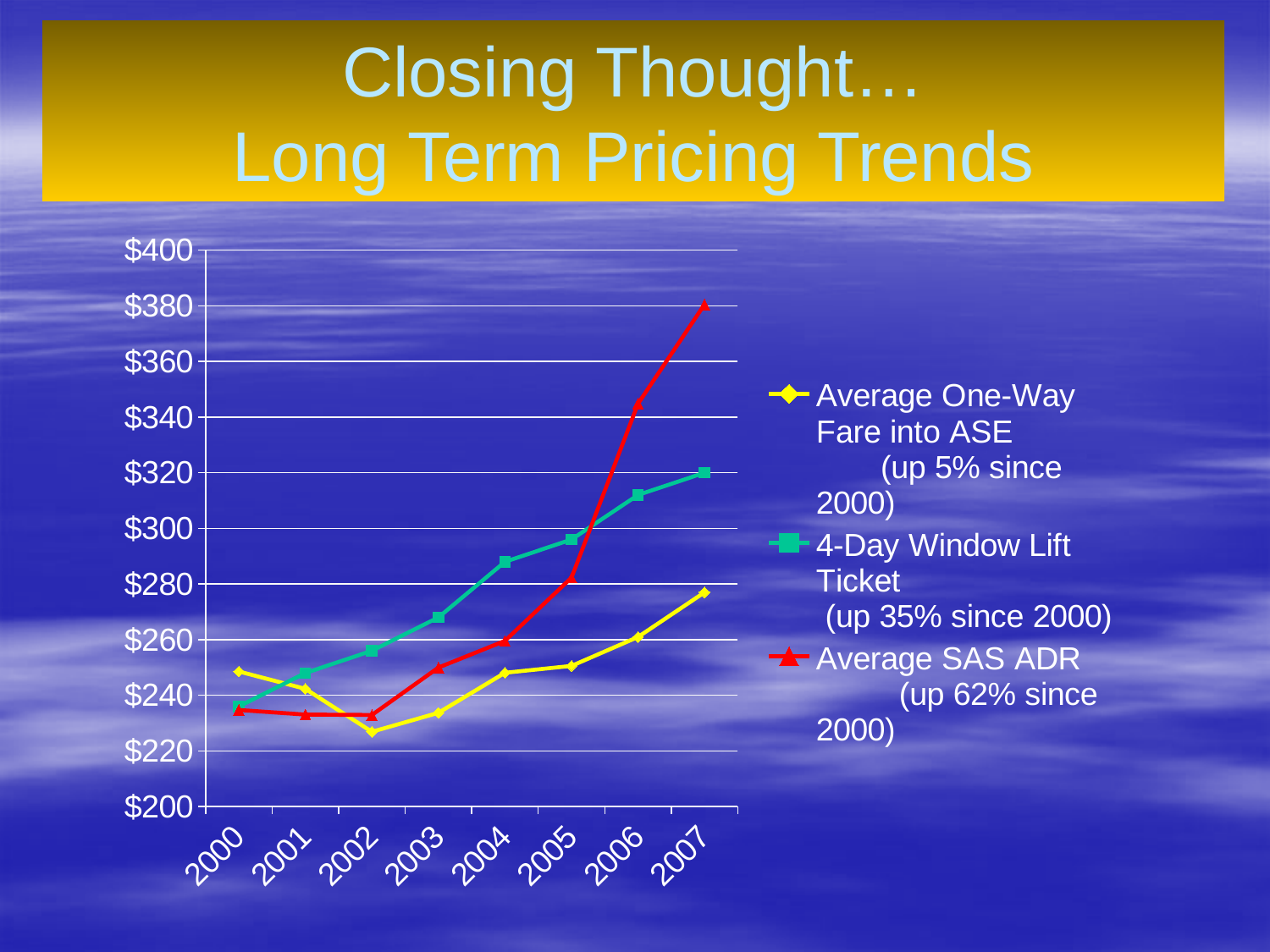
According to the legend, by what percentage has the Average SAS ADR risen since 2000? 62% How many years are shown along the x axis? 8 Is the value for 4-Day Window Lift Ticket in 2004 greater or less than $280? greater Which series has the highest value in 2007? Average SAS ADR Is the value for Average SAS ADR in 2007 greater or less than $360? greater In which year is the Average One-Way Fare into ASE at its lowest? 2002 Is the value for Average One-Way Fare into ASE in 2002 greater or less than $240? less In 2002, which is higher: the 4-Day Window Lift Ticket or the Average One-Way Fare into ASE? 4-Day Window Lift Ticket Does the 4-Day Window Lift Ticket series rise or fall from 2000 to 2007? rise In which year is the Average SAS ADR at its highest? 2007 How many series does the legend list? 3 What kind of chart is shown on the slide? line chart